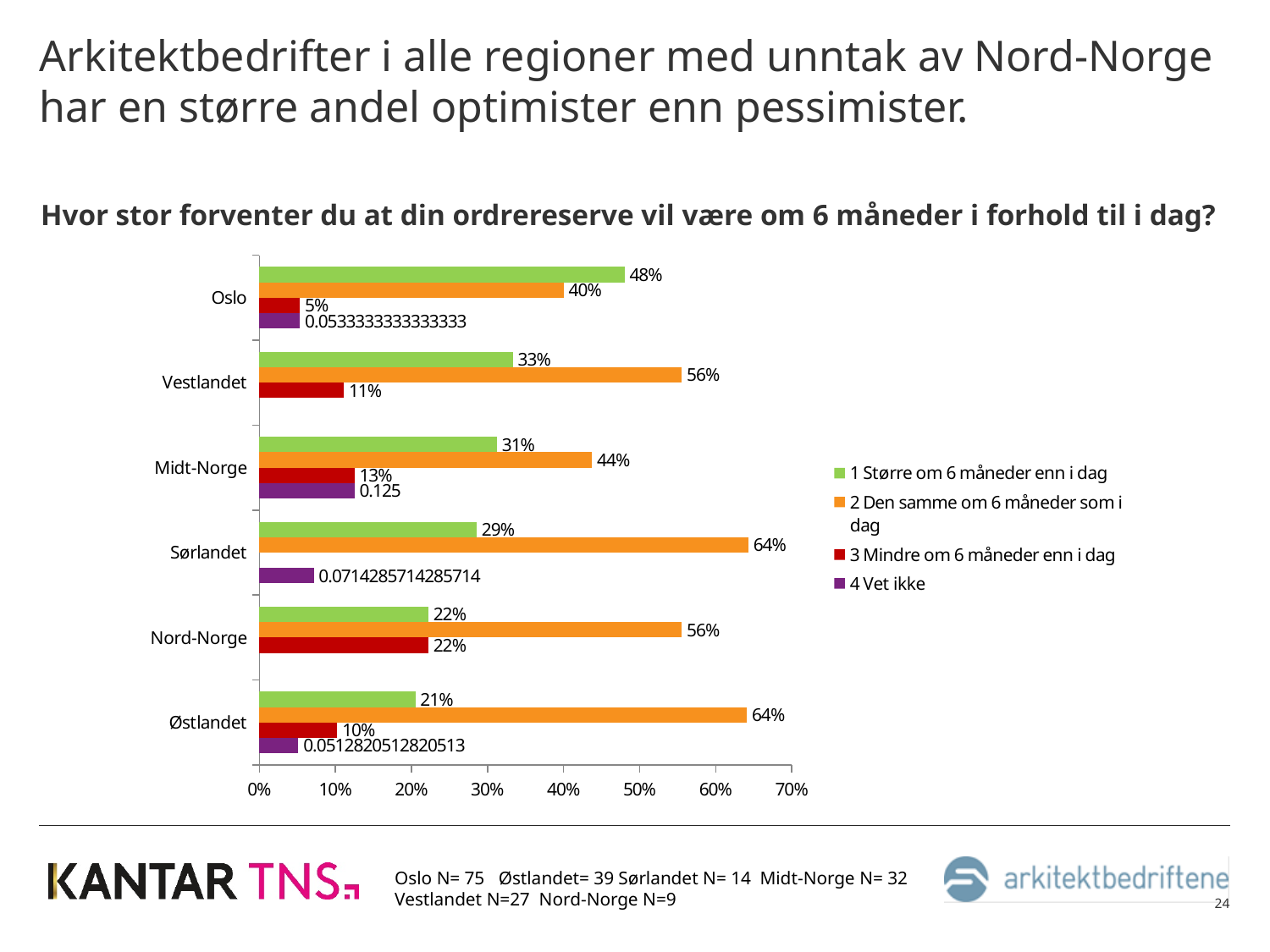
Which region has the highest value in the series '1 Større om 6 måneder enn i dag'? Oslo What is the value for Oslo in the series '1 Større om 6 måneder enn i dag'? 48% What colour are the bars for the series '4 Vet ikke'? purple Which region has the lowest value in the series '1 Større om 6 måneder enn i dag'? Østlandet What is the value for Vestlandet in the series '2 Den samme om 6 måneder som i dag'? 56% How many series does the legend list? 4 What is the value for Nord-Norge in the series '3 Mindre om 6 måneder enn i dag'? 22% What is the difference between the '2 Den samme om 6 måneder som i dag' value for Sørlandet and for Midt-Norge? 20% Which is larger for Midt-Norge: the '1 Større om 6 måneder enn i dag' value or the '2 Den samme om 6 måneder som i dag' value? 2 Den samme om 6 måneder som i dag Is the '3 Mindre om 6 måneder enn i dag' value for Østlandet greater or less than 20%? less What kind of chart is shown on the slide? bar chart How many regions are shown on the chart? 6